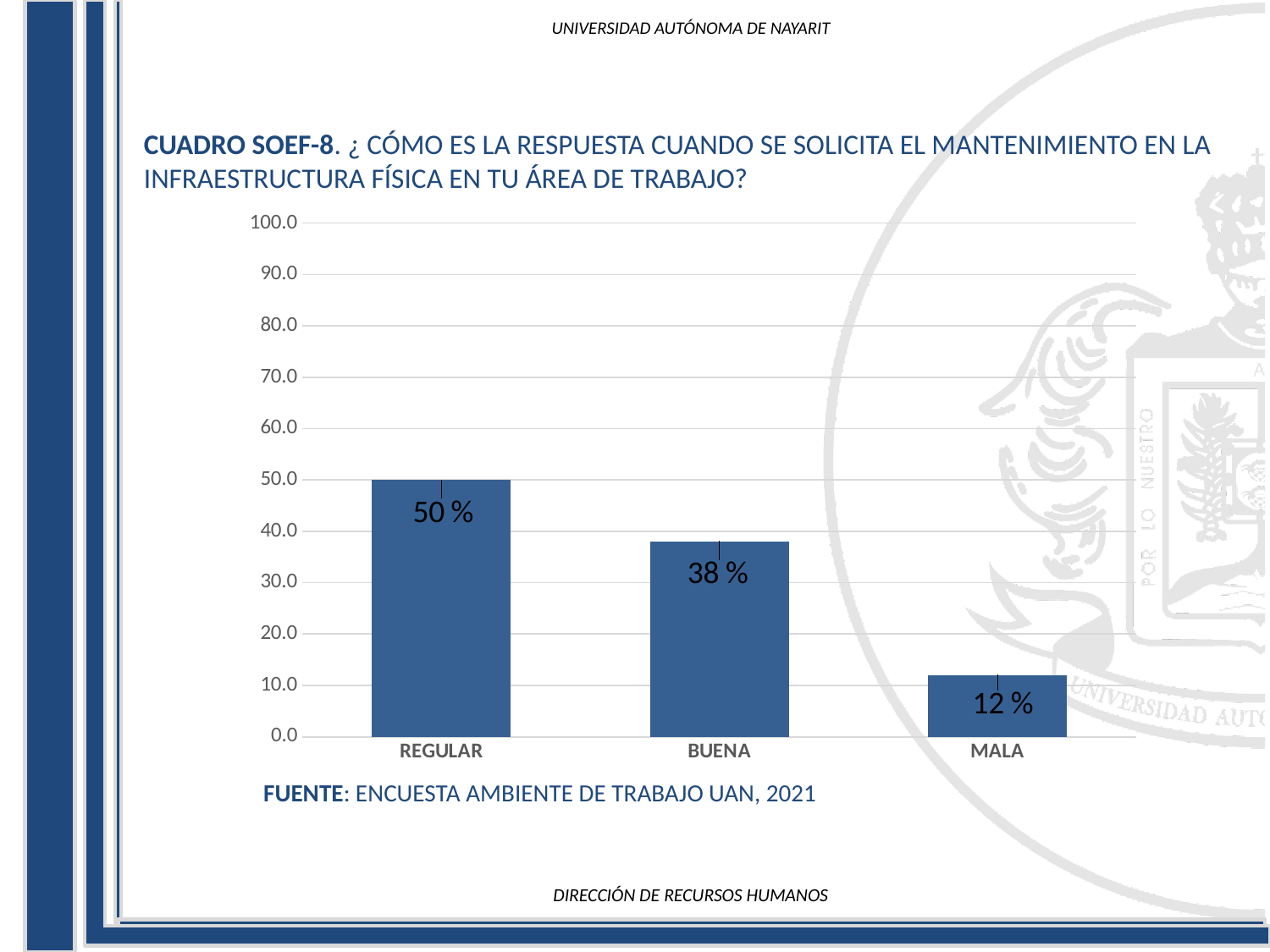
What is the value for BUENA? 38 % Which is larger, the value for BUENA or the value for MALA? BUENA How many categories are shown on the x axis? 3 What is the difference between the values for REGULAR and BUENA? 12 % Do the values rise or fall from left to right along the x axis? fall What kind of chart is shown on the slide? bar chart Which category has the lowest value? MALA What is the value for MALA? 12 % What is the difference between the values for BUENA and MALA? 26 % Is the value for BUENA greater or less than 40.0? less Which category has the highest value? REGULAR What is the value for REGULAR? 50 %